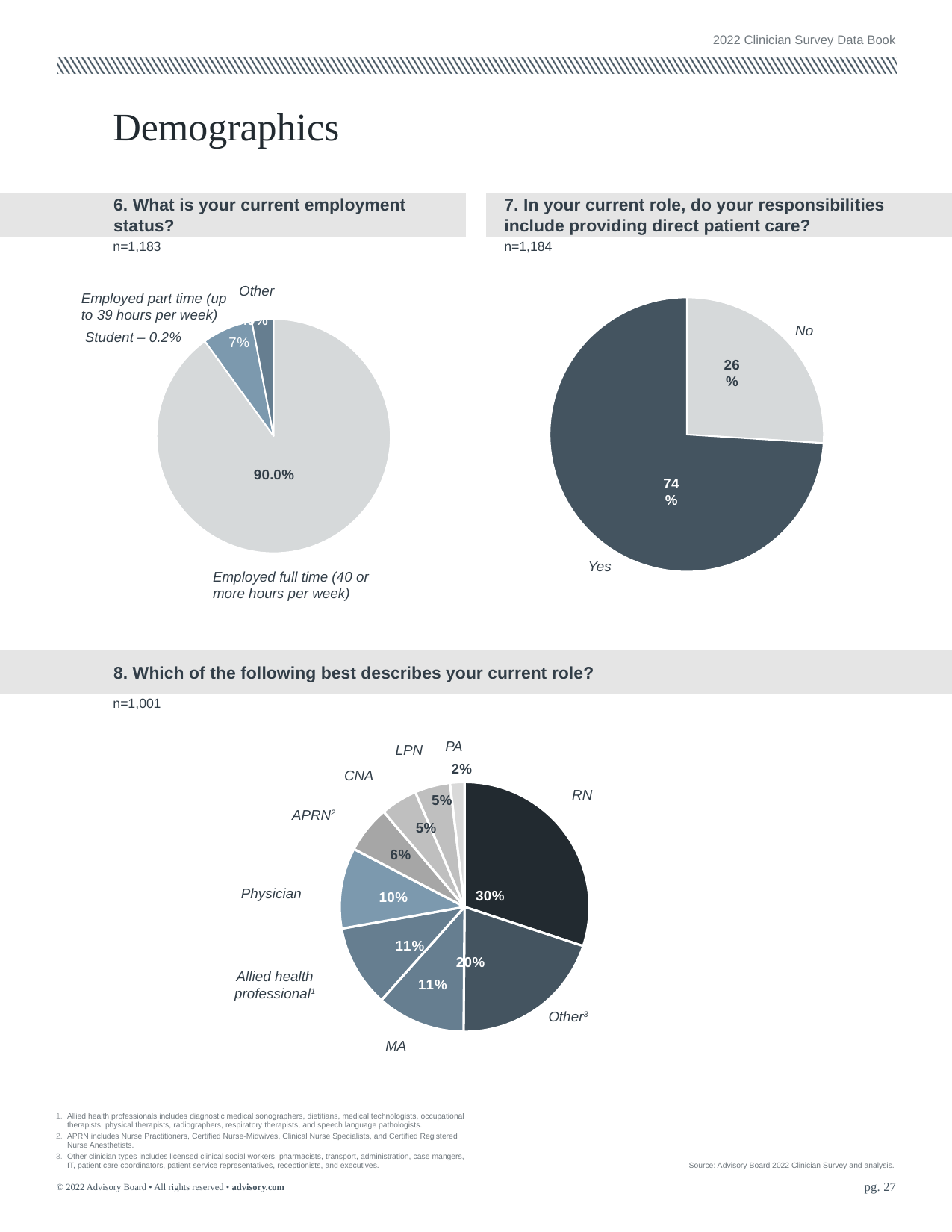
In the chart for question 8 (current role), what share of respondents are RNs? 30% In the chart for question 7 (direct patient care), what share of respondents answered No? 26% In the chart for question 6 (employment status), what share of respondents are employed full time (40 or more hours per week)? 90.0% In the chart for question 7 (direct patient care), which is larger, the Yes slice or the No slice? Yes In the chart for question 8 (current role), which role has the largest share? RN In the chart for question 8 (current role), how many percentage points larger is the RN share than the Other share? 10 percentage points In the chart for question 8 (current role), how many role categories are shown? 9 In the chart for question 8 (current role), which role has the smallest share? PA